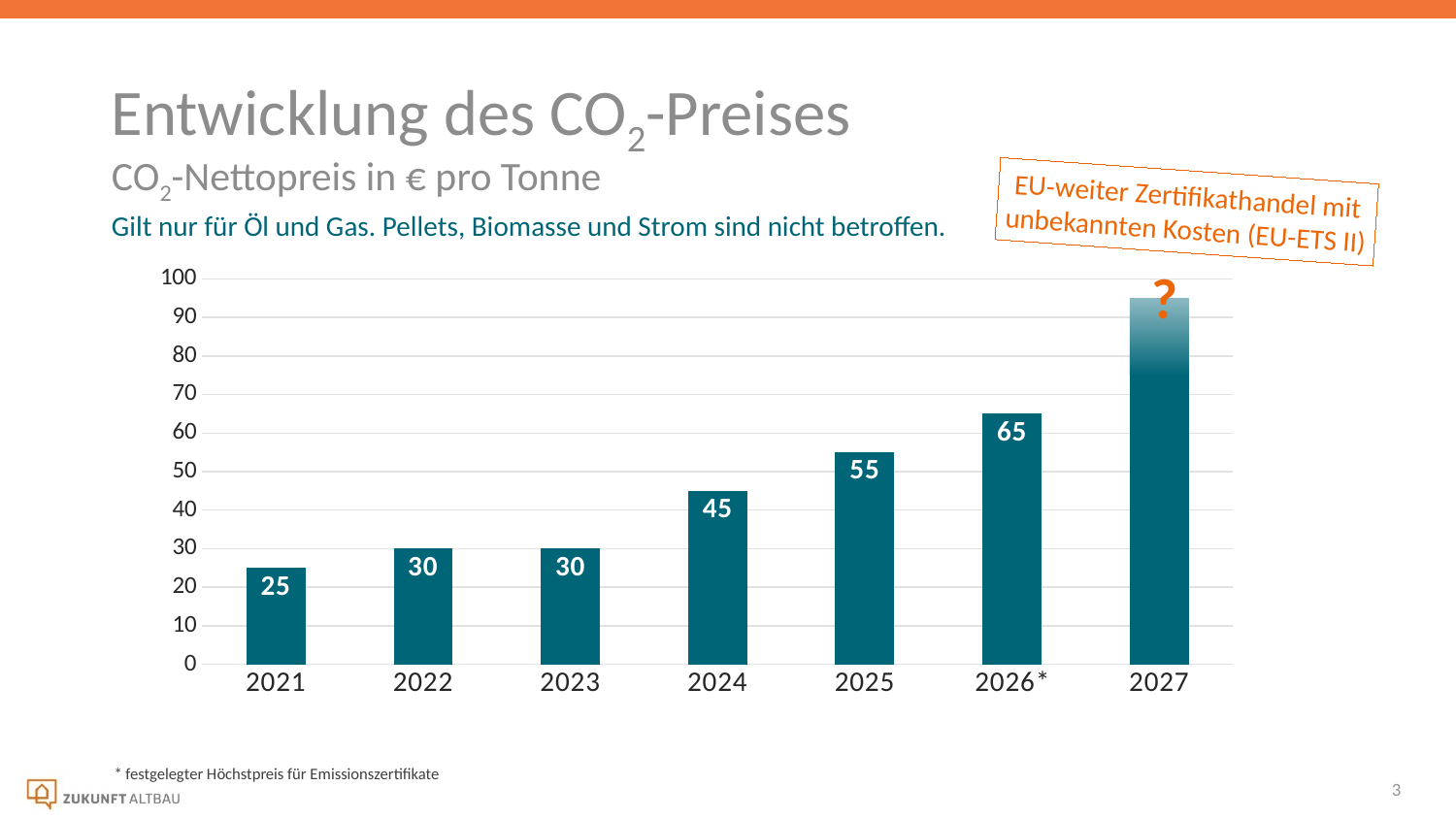
What value is shown for 2024? 45 Which year has the lowest value in the chart? 2021 Is the value for 2027 greater or less than 90? greater How many years are shown on the x axis? 7 Which is larger, the value for 2023 or the value for 2025? 2025 What is the CO2 net price shown for 2021? 25 What label is printed on the bar for 2027 instead of a value? ? What value is shown for 2026*? 65 Which year has the tallest bar in the chart? 2027 What is the difference between the values for 2026* and 2021? 40 What is the difference between the values for 2025 and 2024? 10 What kind of chart is shown on the slide? bar chart